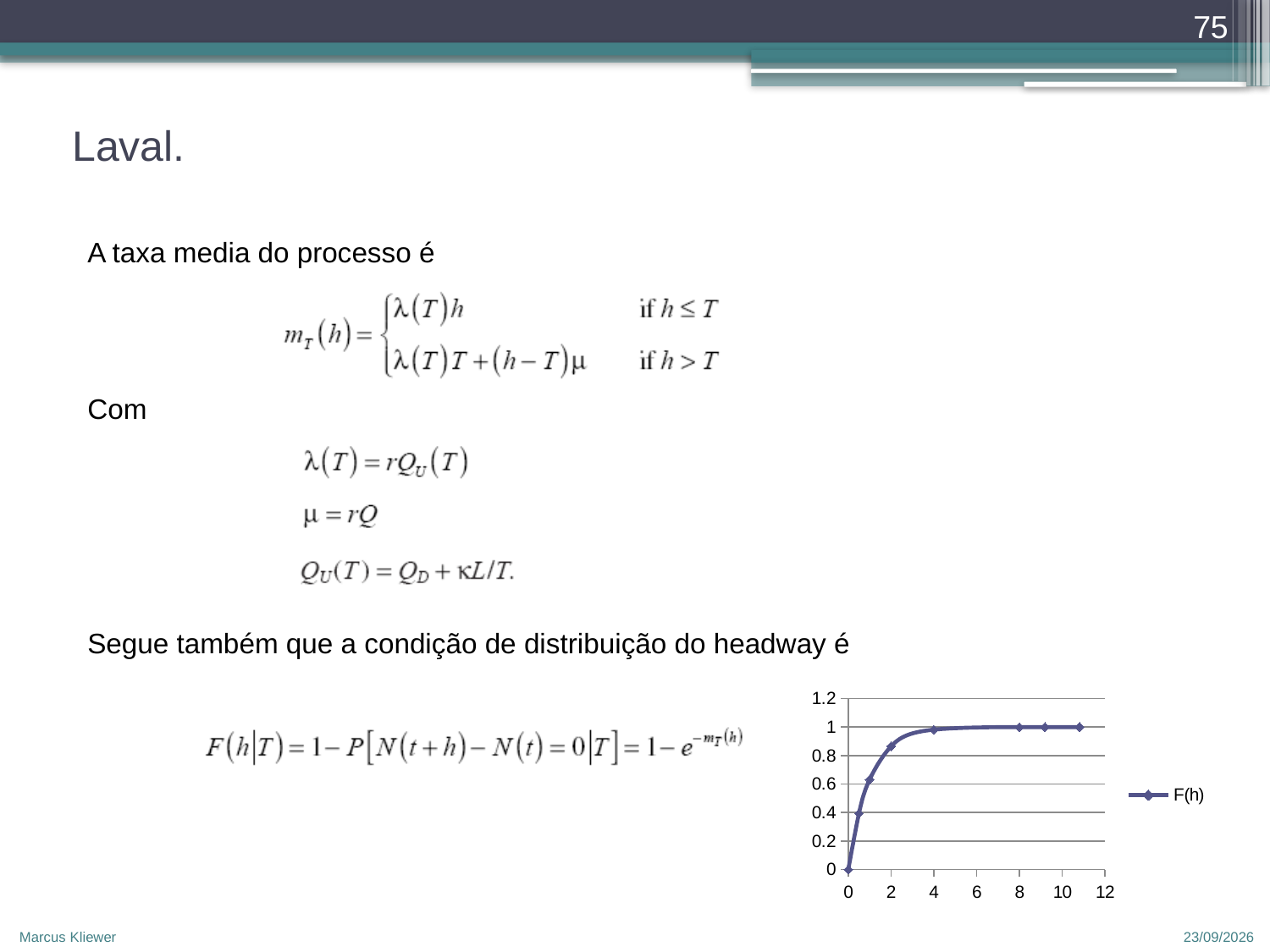
How many series does the chart legend list? 1 Do the values of F(h) rise or fall as h increases along the x axis? rise What is the value of F(h) at h = 0? 0 What is the name of the series shown in the chart legend? F(h) Is the value of F(h) at h = 4 greater or less than 0.8? greater Is the value of F(h) at h = 2 greater or less than 0.6? greater Which is larger, the value of F(h) at h = 1 or at h = 4? h = 4 How many data points are plotted on the F(h) line? 8 Is the value of F(h) at h = 8 greater or less than 0.8? greater What kind of chart is shown on the slide? line chart What is the highest value shown on the y axis of the chart? 1.2